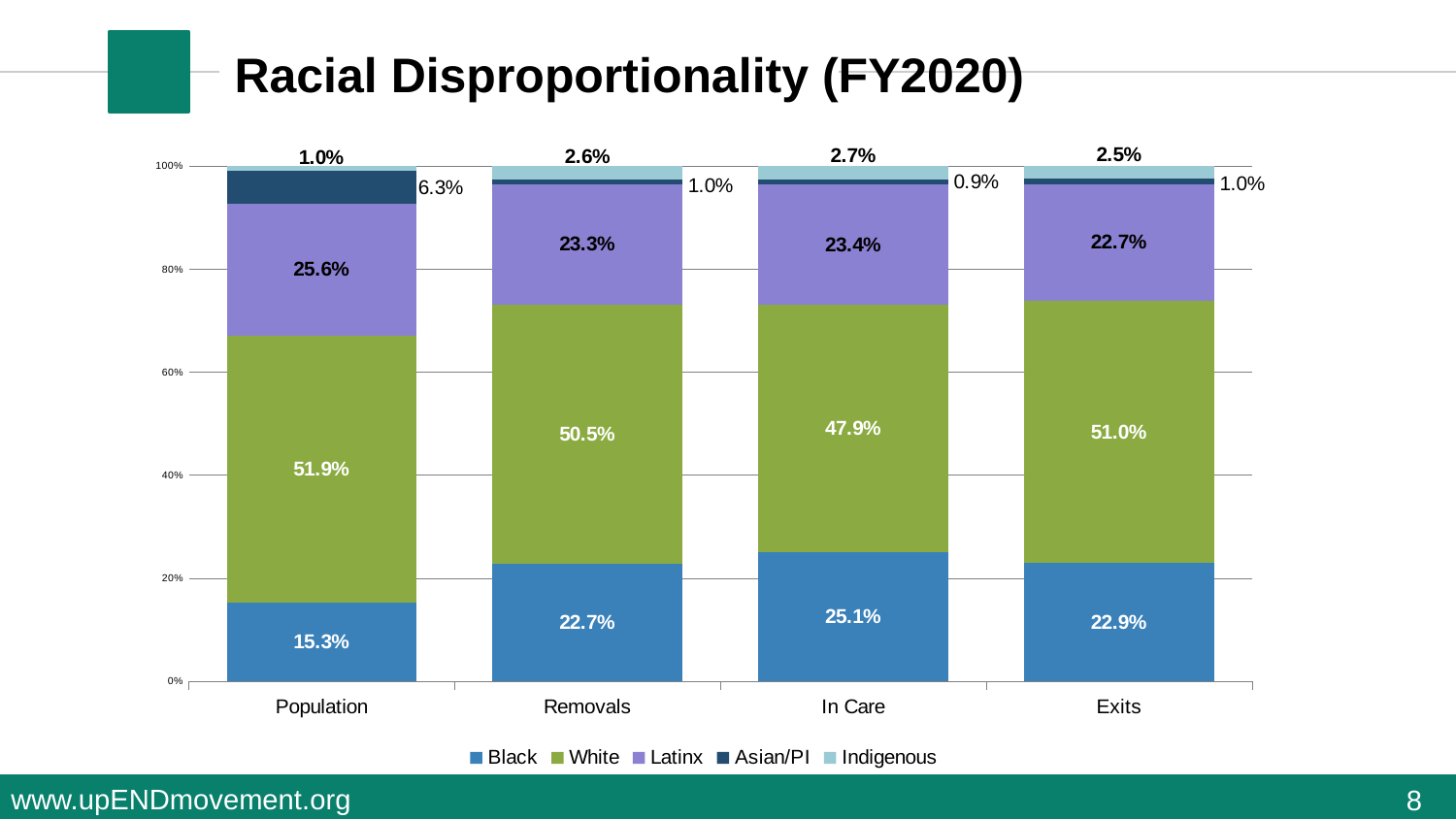
What is the Black share for In Care? 25.1% What kind of chart is shown on the slide? Stacked bar chart How many categories are shown on the x axis? 4 What is the difference between the Black share for In Care and the Black share for Population? 9.8% What is the White share for Population? 51.9% How many series does the legend list? 5 Is the Latinx share larger for Population or for Removals? Population What is the Latinx share for Exits? 22.7% Which category has the highest Black share? In Care Which category has the lowest White share? In Care What is the Indigenous share for Removals? 2.6% What is the Asian/PI share for Population? 6.3%